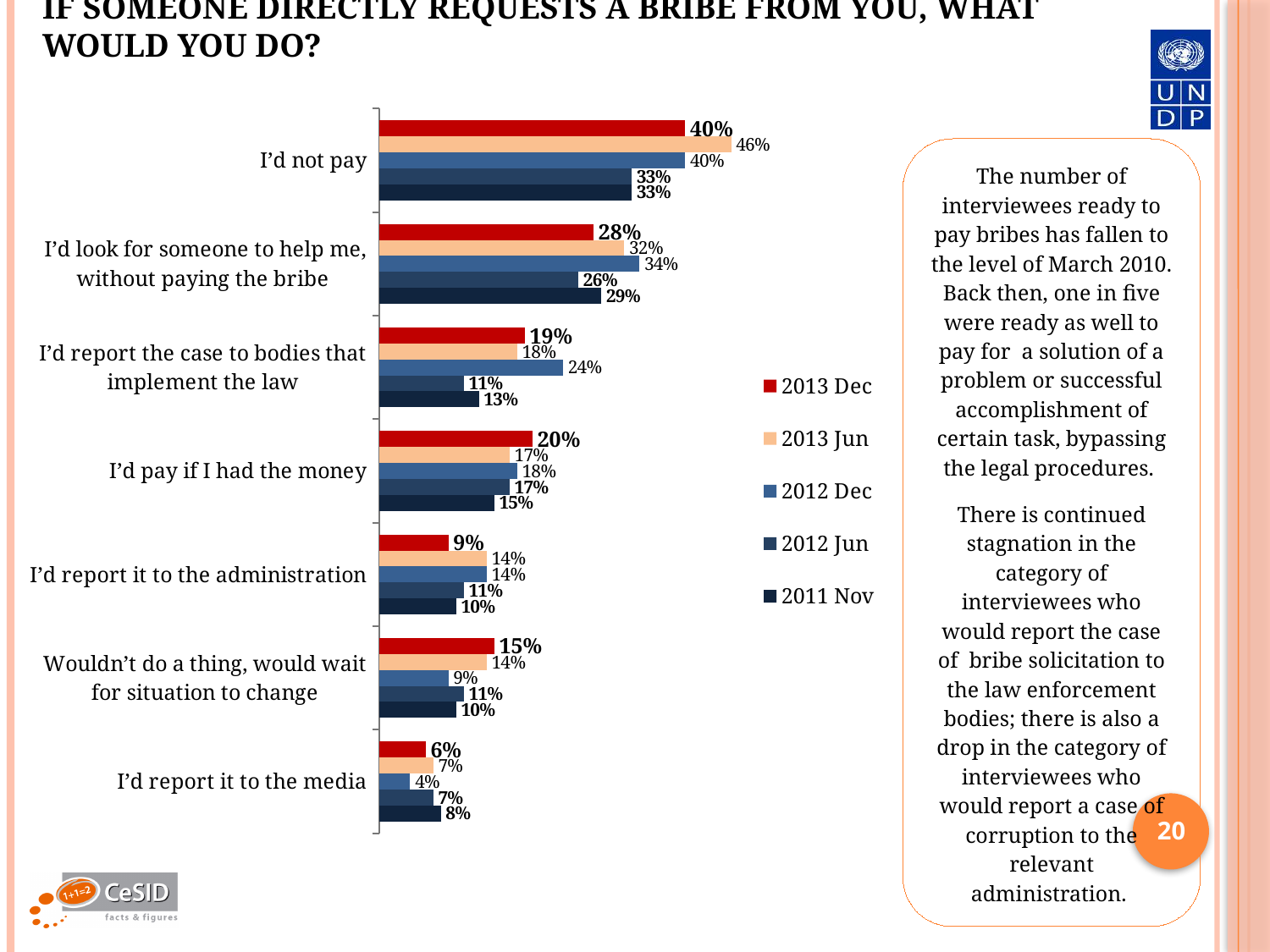
How many series does the legend list? 5 What kind of chart is shown on the slide? bar chart Which category has the lowest 2012 Dec value? I'd report it to the media What is the 2011 Nov value for "I'd report it to the media"? 8% Which category has the highest 2013 Dec value? I'd not pay What is the 2012 Dec value for "I'd report the case to bodies that implement the law"? 24% Which series is shown in red in the legend? 2013 Dec How many response categories are shown on the chart? 7 What is the 2013 Dec value for "I'd not pay"? 40% What is the difference between the 2013 Jun and 2013 Dec values for "I'd not pay"? 6% For "I'd report it to the administration", which is larger: the 2013 Dec value or the 2013 Jun value? 2013 Jun What is the 2013 Jun value for "I'd not pay"? 46%